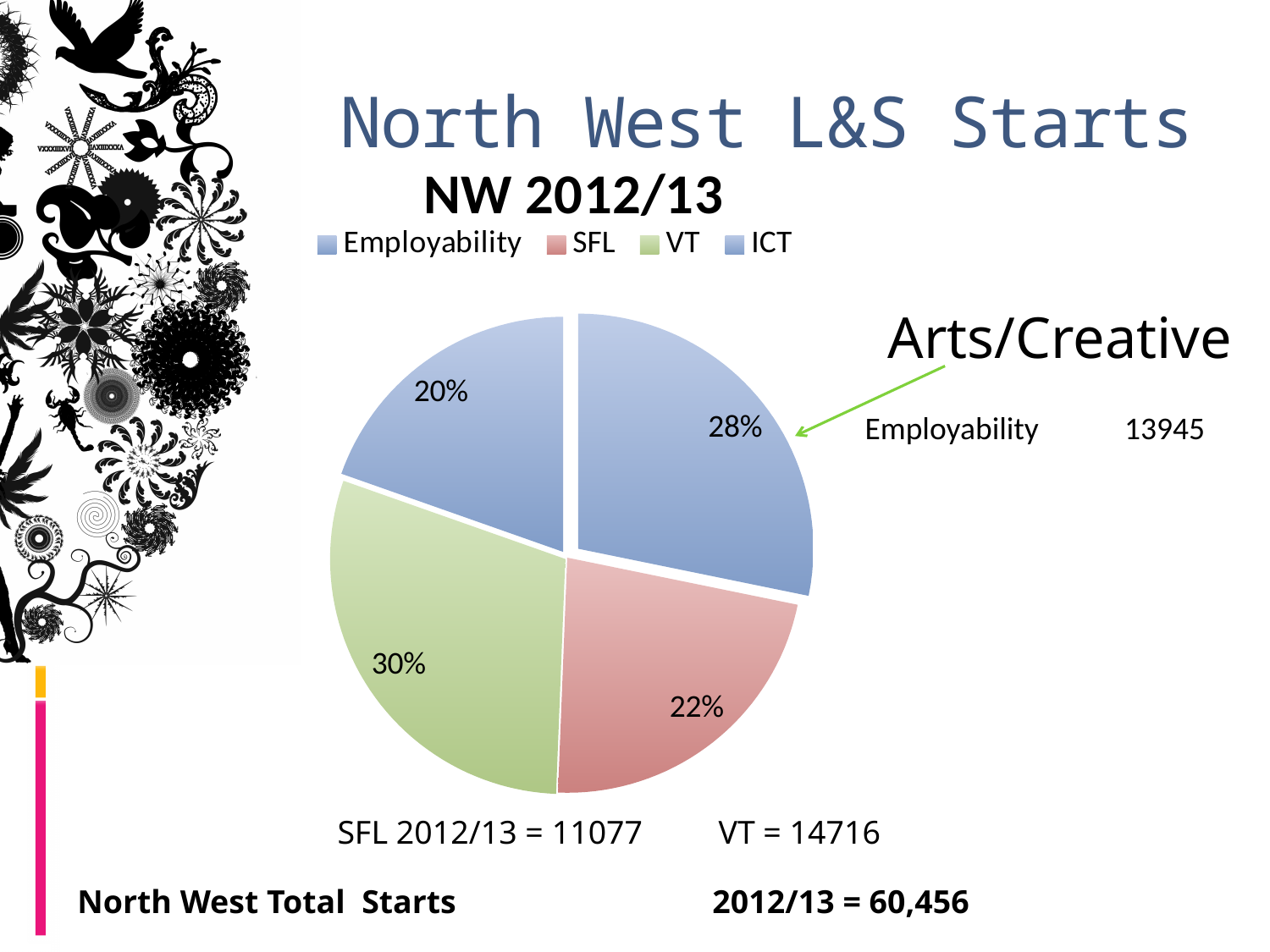
What share of the pie does Employability represent? 28% How many entries does the legend of the pie chart list? 4 What is the difference in percentage points between the VT slice and the ICT slice? 10 Which slice is larger, Employability or SFL? Employability How many slices does the pie chart have? 4 Which category has the smallest slice of the pie? ICT What kind of chart is shown on the slide? pie chart What share of the pie does VT represent? 30% What share of the pie does SFL represent? 22% Which category has the largest slice of the pie? VT What is the title of the pie chart? NW 2012/13